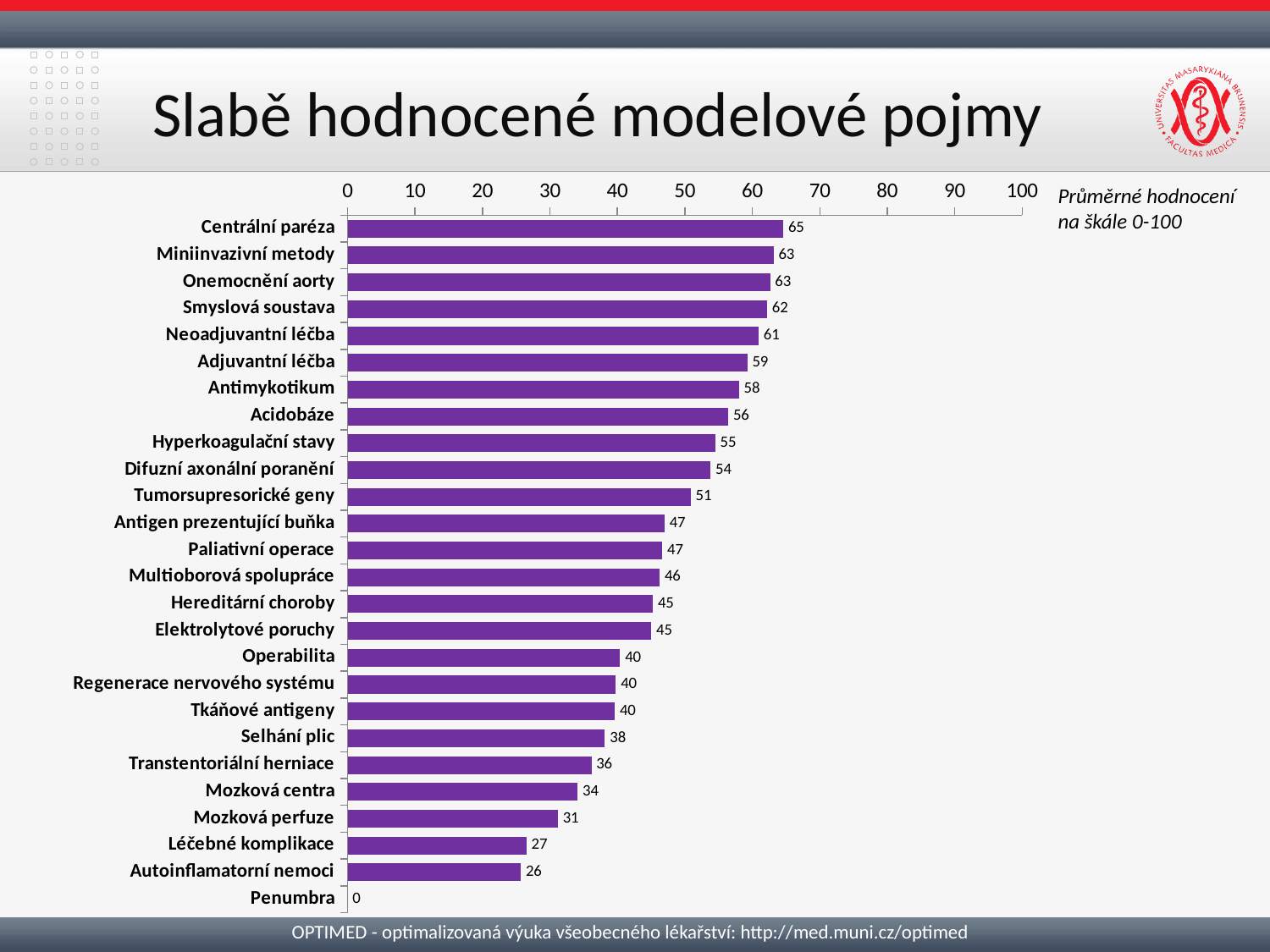
What is the value for Mozková perfuze? 31 What kind of chart is shown on the slide? Bar chart What is the difference between the values for Centrální paréza and Autoinflamatorní nemoci? 39 How many categories are shown in the chart? 26 What is the value for Centrální paréza? 65 Which category has the lowest value? Penumbra What is the title of the slide? Slabě hodnocené modelové pojmy Which is larger, the value for Antimykotikum or the value for Selhání plic? Antimykotikum What is the maximum value shown on the axis of the chart? 100 Which category has the highest value? Centrální paréza What is the value for Acidobáze? 56 What is the value for Penumbra? 0